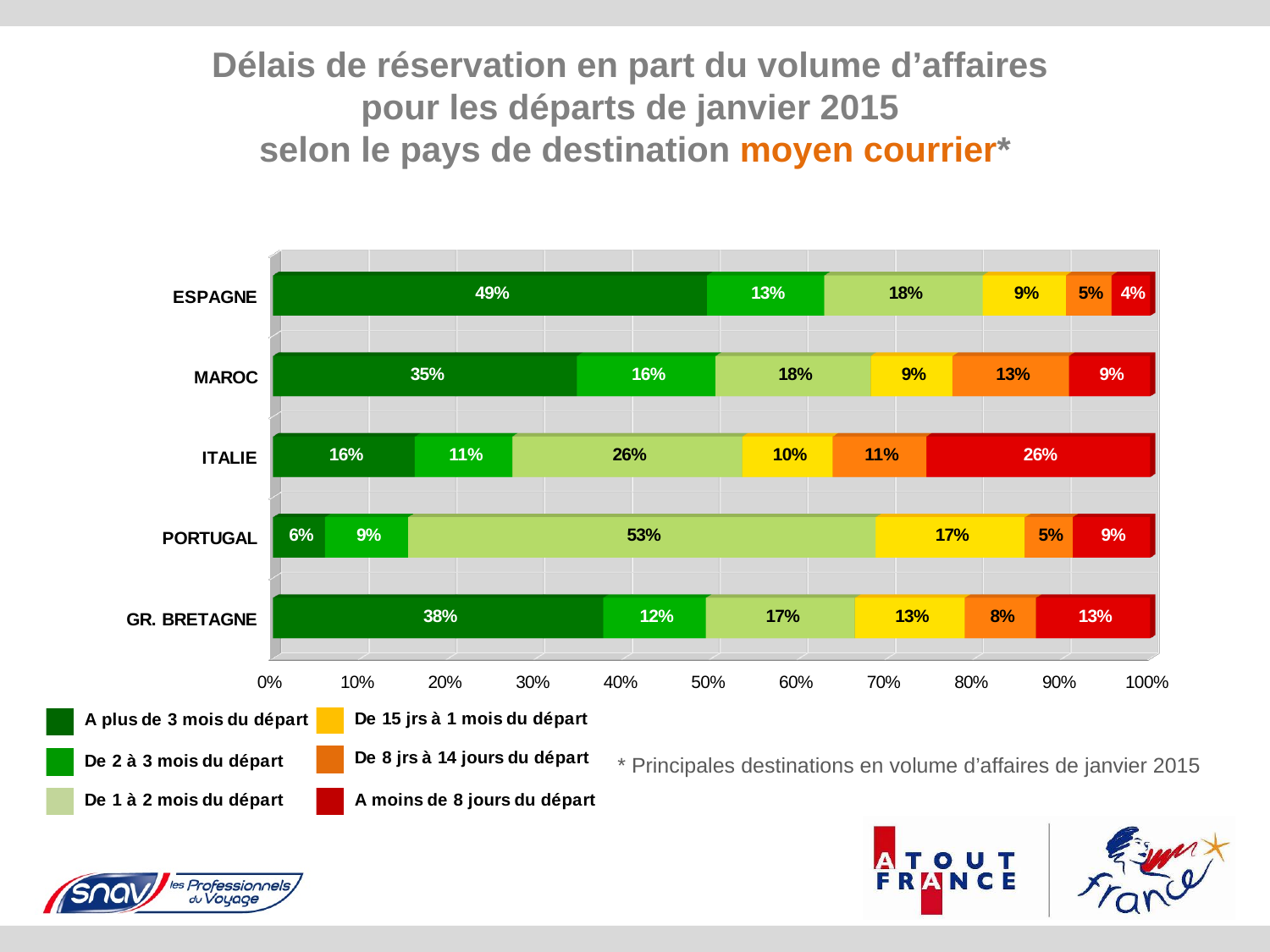
What is the value for PORTUGAL in the 'De 1 à 2 mois du départ' series? 53% What is the value for GR. BRETAGNE in the 'De 8 jrs à 14 jours du départ' series? 8% What kind of chart is shown on the slide? Stacked bar chart How many series does the legend list? 6 Which is larger: the 'A moins de 8 jours du départ' value for ITALIE or for MAROC? ITALIE Which colour represents the 'De 15 jrs à 1 mois du départ' series? Yellow Which country has the highest value in the 'A plus de 3 mois du départ' series? ESPAGNE Which country has the lowest value in the 'A plus de 3 mois du départ' series? PORTUGAL What is the value for ITALIE in the 'A moins de 8 jours du départ' series? 26% What is the difference between MAROC and ESPAGNE in the 'A plus de 3 mois du départ' series? 14% What is the value for ESPAGNE in the 'A plus de 3 mois du départ' series? 49% How many countries are shown on the chart? 5